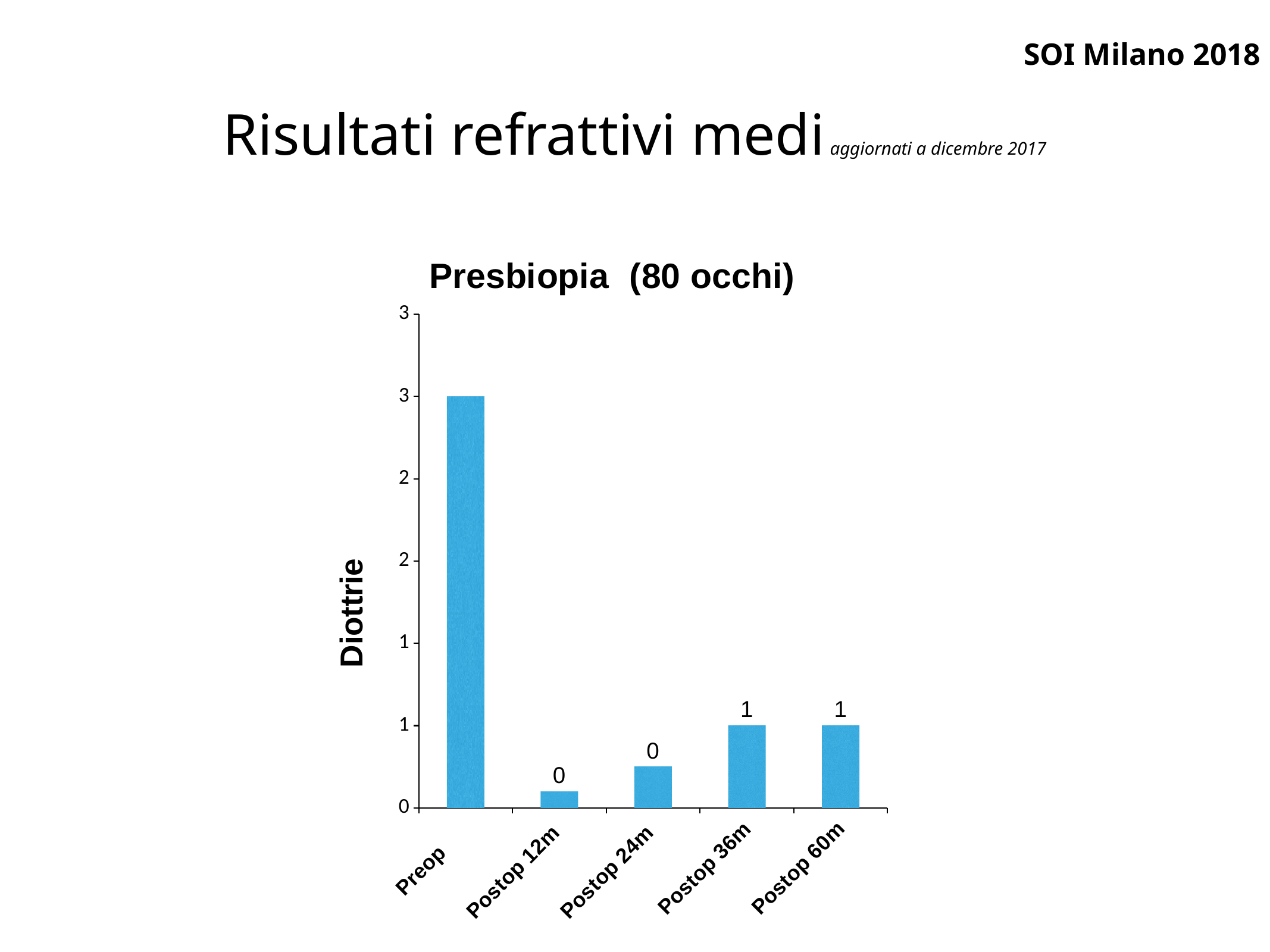
Which category has the highest bar? Preop What is the data label shown for Postop 60m? 1 What is the difference between the labelled values for Postop 36m and Postop 12m? 1 What is the data label shown for Postop 12m? 0 What is the data label shown for Postop 36m? 1 Is the value for Postop 24m greater or less than 1? less Which category has the lowest bar? Postop 12m What kind of chart is shown on the slide? bar chart What is the title of the chart? Presbiopia (80 occhi) How many categories are shown on the x axis? 5 Which is larger, the value for Preop or the value for Postop 36m? Preop Is the value for Preop greater or less than 2? greater